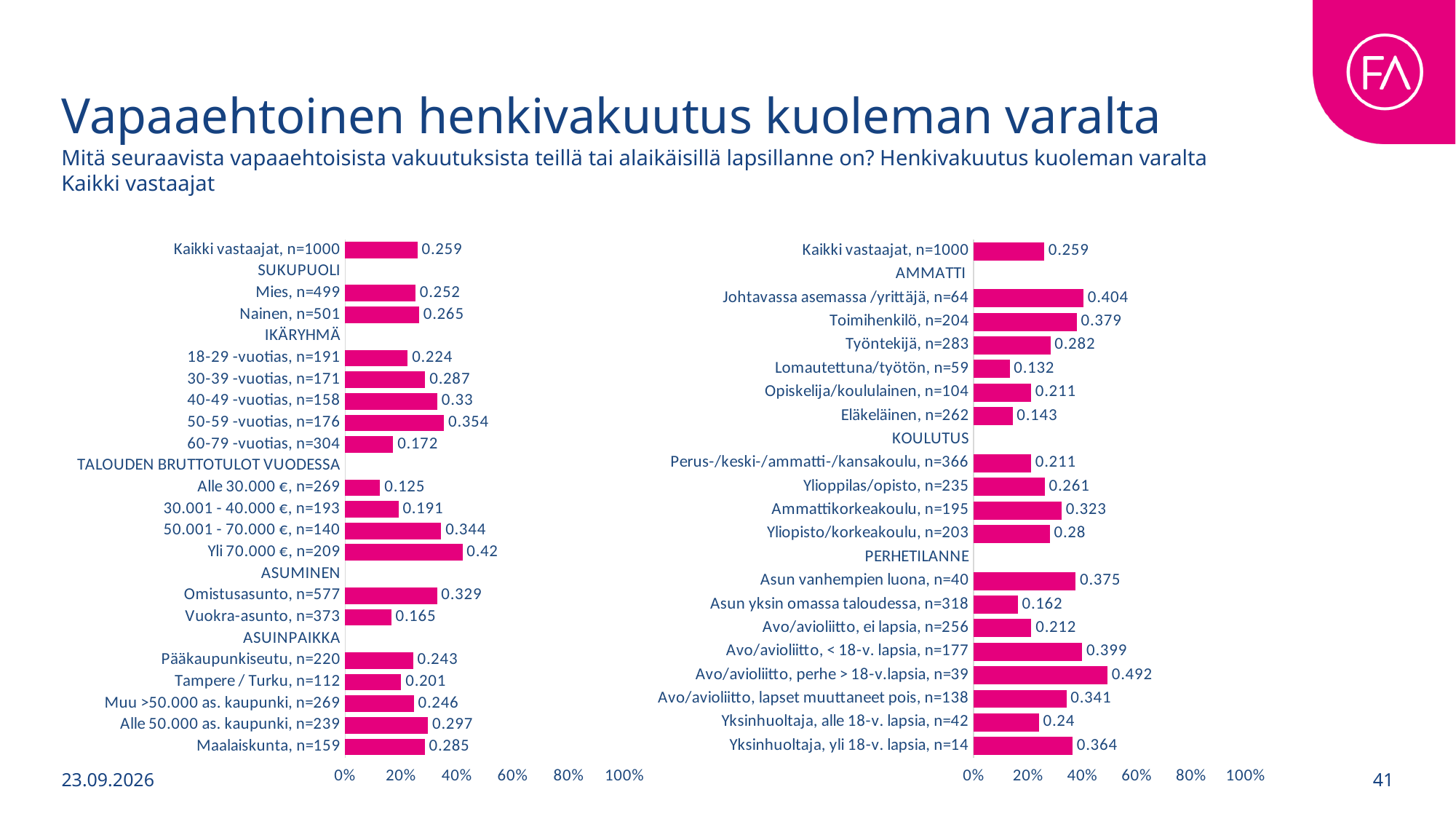
In the left chart, which category has the lowest value? Alle 30.000 €, n=269 In the left chart, what is the difference between the values for Omistusasunto, n=577 and Vuokra-asunto, n=373? 0.164 In the left chart, what is the value for Kaikki vastaajat, n=1000? 0.259 In the right chart, what is the value for Yksinhuoltaja, yli 18-v. lapsia, n=14? 0.364 In the right chart, which category has the lowest value? Lomautettuna/työtön, n=59 In the right chart, which category has the highest value? Avo/avioliitto, perhe > 18-v.lapsia, n=39 In the left chart, what is the value for 50-59 -vuotias, n=176? 0.354 In the right chart, what is the value for Toimihenkilö, n=204? 0.379 In the left chart, which category has the highest value? Yli 70.000 €, n=209 In the right chart, which is larger: the value for Ammattikorkeakoulu, n=195 or Yliopisto/korkeakoulu, n=203? Ammattikorkeakoulu, n=195 What kind of chart is the left chart? bar chart In the right chart, is the value for Lomautettuna/työtön, n=59 greater or less than 20%? less